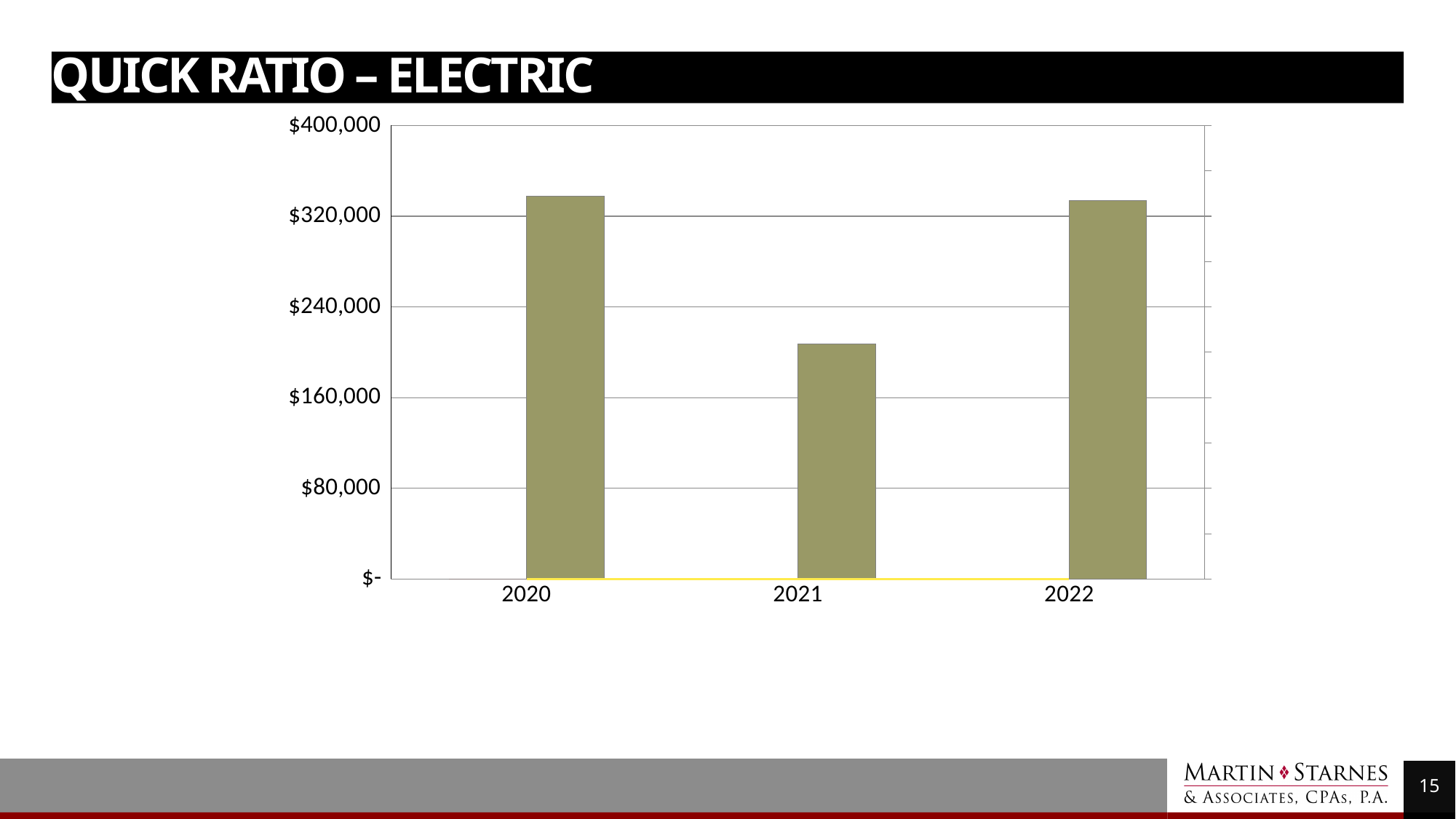
What is the title of the chart? QUICK RATIO – ELECTRIC How many years are plotted on the x axis? 3 Is the value for 2020 greater or less than $320,000? greater Which year has the lowest value? 2021 Is the value for 2022 greater or less than $320,000? greater What kind of chart is shown on the slide? bar chart Is the value for 2021 greater or less than $160,000? greater Does the value rise or fall from 2021 to 2022? rise Which is larger, the value for 2021 or the value for 2022? 2022 Which is larger, the value for 2020 or the value for 2021? 2020 Does the value rise or fall from 2020 to 2021? fall